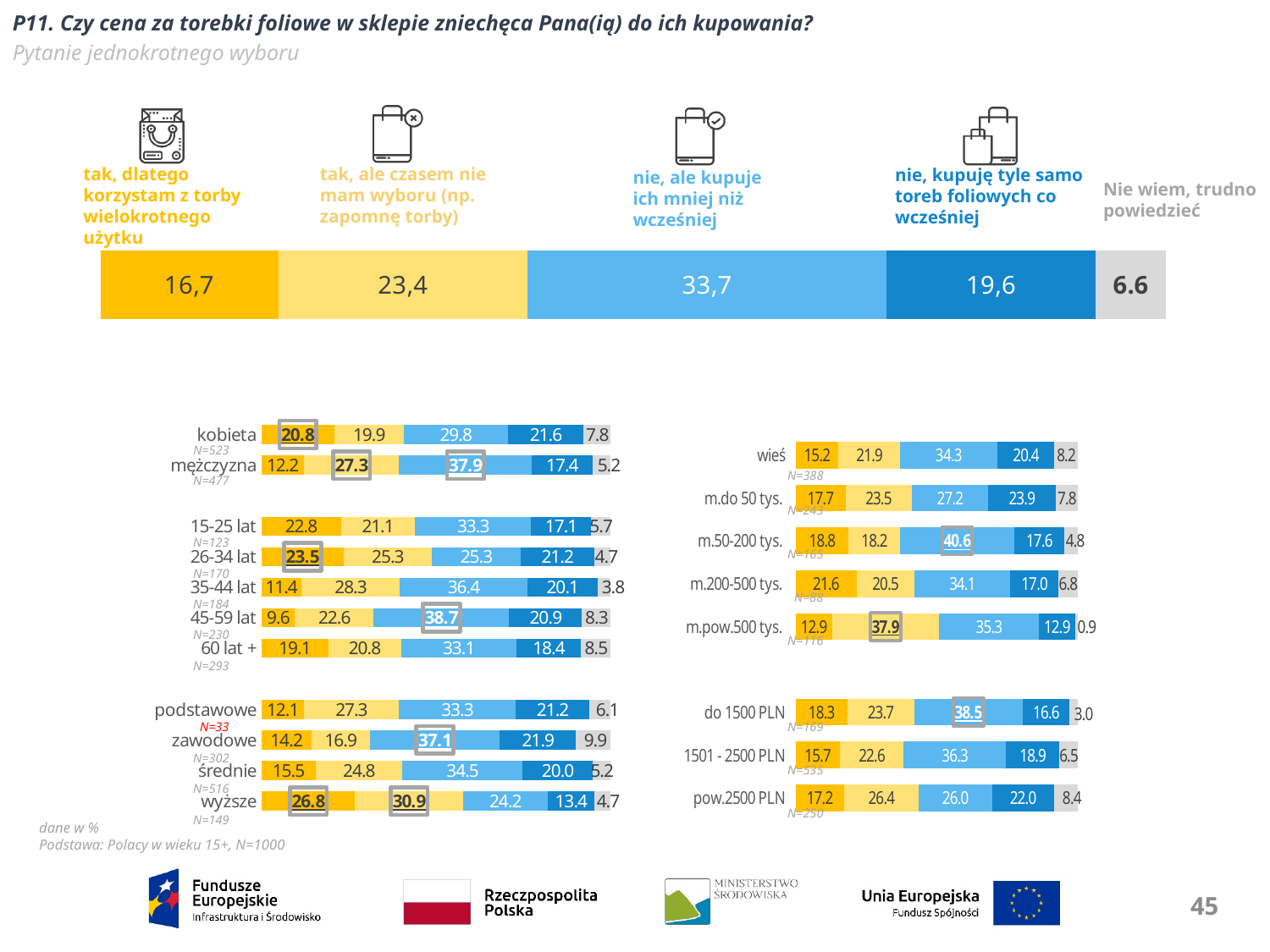
In the place-of-residence chart on the right, what is the value of the light blue segment for "m.50-200 tys."? 40.6 In the education chart on the left, what is the value of the first (dark yellow) segment for "wyższe"? 26.8 In the income chart on the right, which income group has the larger light blue segment: "do 1500 PLN" or "pow.2500 PLN"? do 1500 PLN In the gender chart on the left, what is the difference between the light blue segment for "mężczyzna" (37.9) and for "kobieta" (29.8)? 8.1 In the age chart on the left, which age group has the highest value in the light blue segment? 45-59 lat In the gender chart on the left, what is the value of the first (dark yellow) segment for "kobieta"? 20.8 In the overall stacked bar at the top of the slide, which response category has the lowest value? Nie wiem, trudno powiedzieć In the overall stacked bar at the top of the slide, which response category has the highest value? nie, ale kupuje ich mniej niż wcześniej In the gender chart on the left, what is the value of the light blue segment for "mężczyzna"? 37.9 In the overall stacked bar at the top of the slide, what is the value for the segment "nie, ale kupuje ich mniej niż wcześniej"? 33,7 In the overall stacked bar at the top of the slide, how many response categories does the legend list? 5 What type of chart is used to show the results on this slide? stacked bar chart